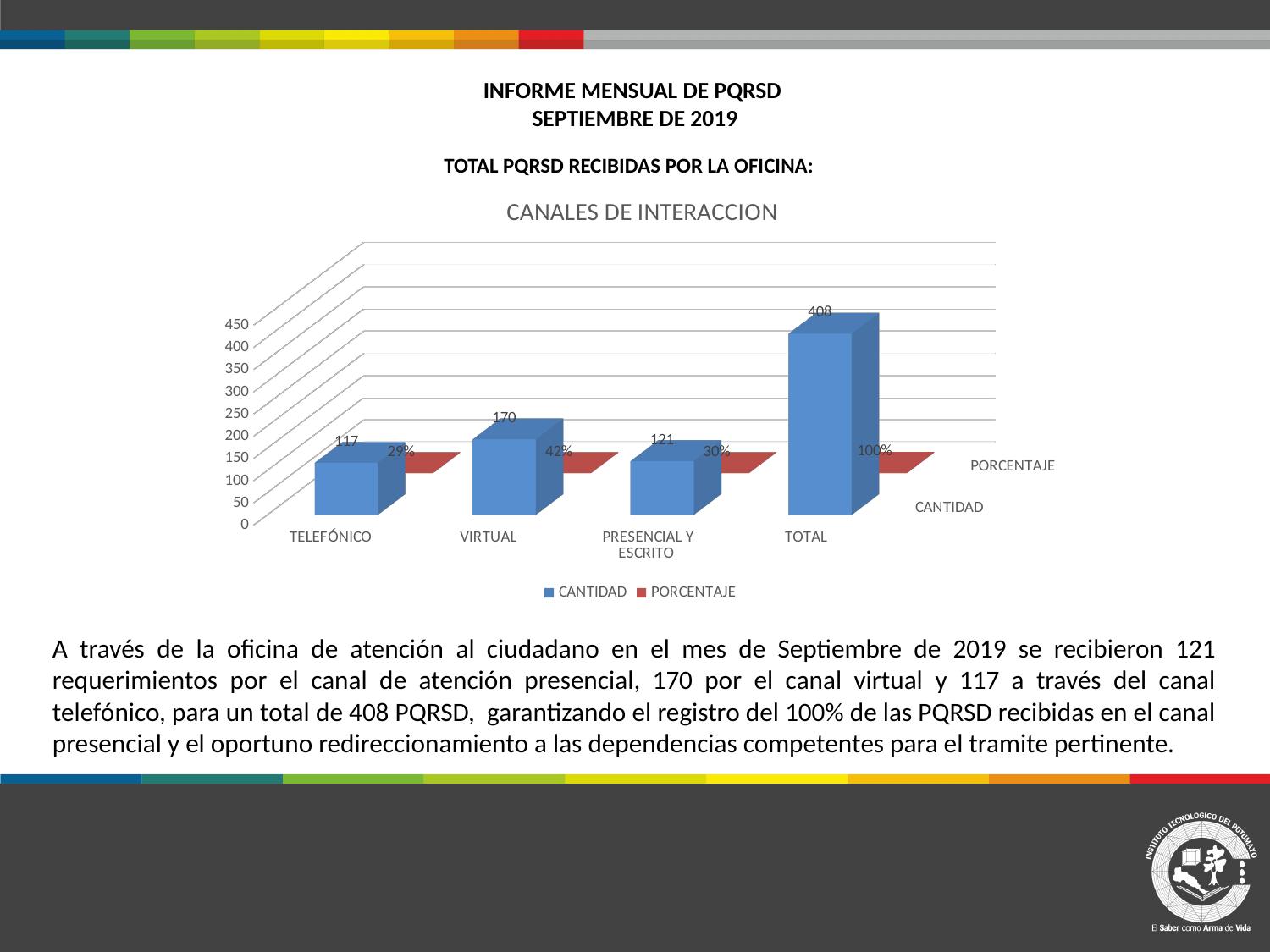
Which has a larger CANTIDAD value, TELEFÓNICO or VIRTUAL? VIRTUAL What is the CANTIDAD value for TELEFÓNICO? 117 How many series does the chart legend list? 2 What type of chart is CANALES DE INTERACCION? Bar chart How many categories are shown on the x axis of the chart? 4 What PORCENTAJE is shown for PRESENCIAL Y ESCRITO? 30% Excluding TOTAL, which channel has the lowest CANTIDAD value? TELEFÓNICO Which category has the highest CANTIDAD value? TOTAL What is the CANTIDAD value for VIRTUAL in the CANALES DE INTERACCION chart? 170 What is the CANTIDAD value for TOTAL? 408 What is the title of the chart on the slide? CANALES DE INTERACCION What is the difference between the CANTIDAD values for VIRTUAL and PRESENCIAL Y ESCRITO? 49